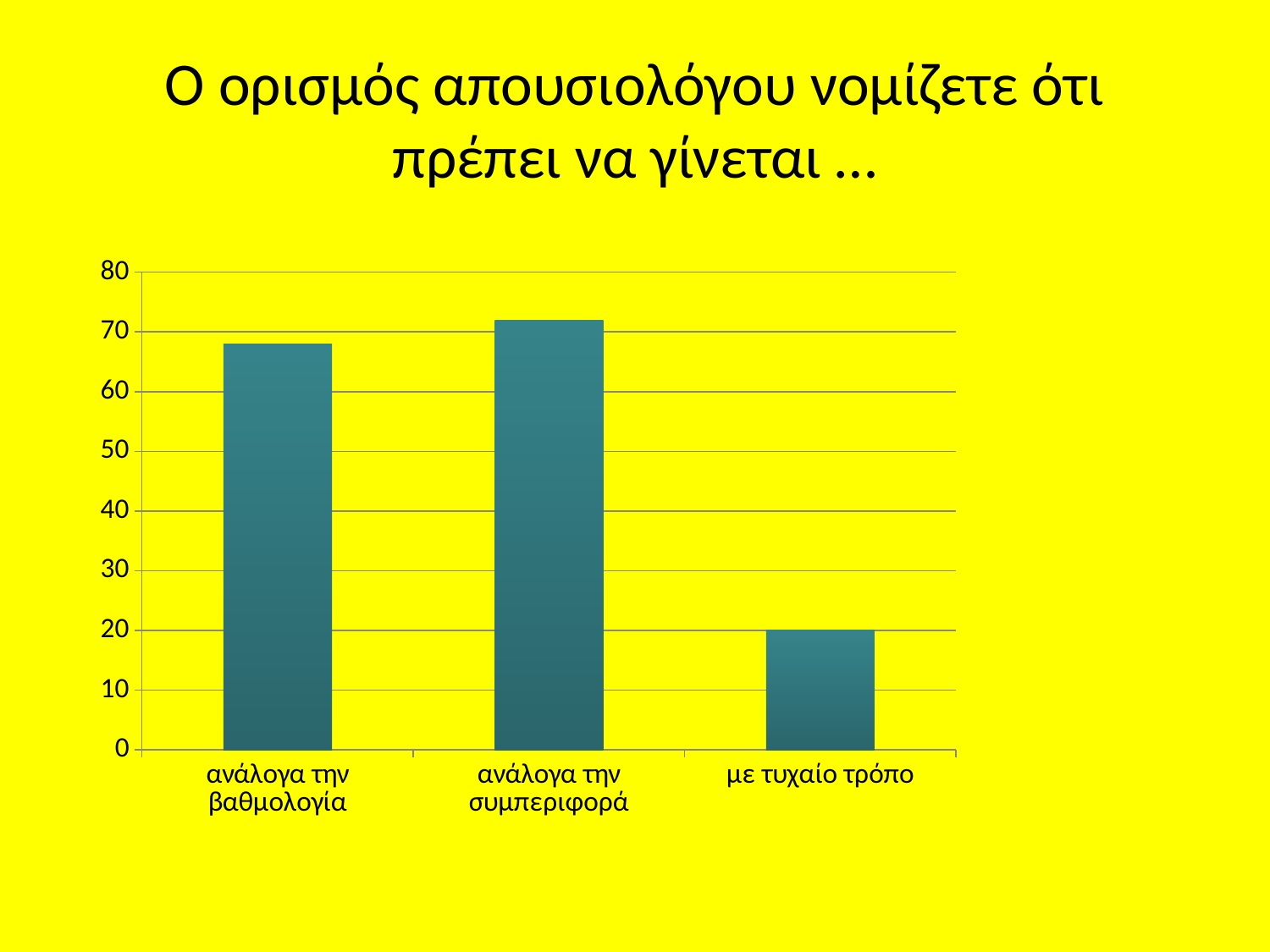
How many categories are shown on the x axis of the chart? 3 What type of chart is shown on the slide? bar chart Which category has the lowest bar? με τυχαίο τρόπο Which is larger, the value for "ανάλογα την βαθμολογία" or the value for "με τυχαίο τρόπο"? ανάλογα την βαθμολογία Which category has the highest bar? ανάλογα την συμπεριφορά What is the value for "με τυχαίο τρόπο"? 20 Is the value for "ανάλογα την συμπεριφορά" greater or less than 70? greater Is the value for "ανάλογα την βαθμολογία" greater or less than 70? less Is the value for "ανάλογα την βαθμολογία" greater or less than 60? greater Which is larger, the value for "ανάλογα την βαθμολογία" or the value for "ανάλογα την συμπεριφορά"? ανάλογα την συμπεριφορά What is the title of the slide above the chart? Ο ορισμός απουσιολόγου νομίζετε ότι πρέπει να γίνεται ...